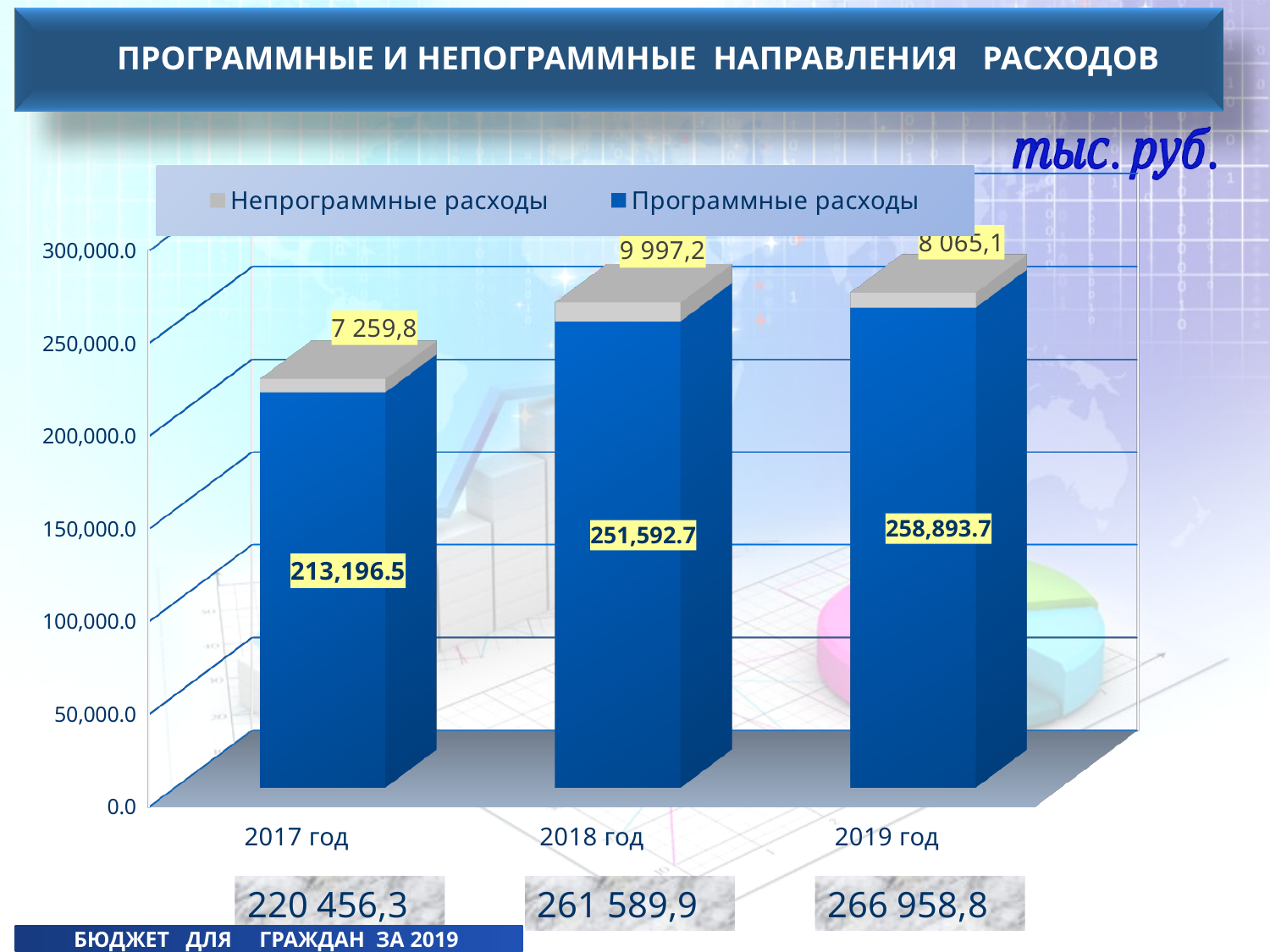
Which year has the lowest value of Непрограммные расходы? 2017 год What is the value of Непрограммные расходы for 2017 год? 7 259,8 What is the value of Непрограммные расходы for 2018 год? 9 997,2 What is the value of Программные расходы for 2017 год? 213,196.5 How many categories (years) are shown on the x axis? 3 What is the value of Программные расходы for 2019 год? 258,893.7 Is the value of Программные расходы for 2017 год greater or less than 250,000.0? less Do the values of Программные расходы rise or fall from 2017 год to 2019 год? rise Which year has the highest value of Программные расходы? 2019 год What type of chart is shown on the slide? bar chart What is the difference between Программные расходы in 2018 год and 2017 год? 38,396.2 How many series does the legend list? 2